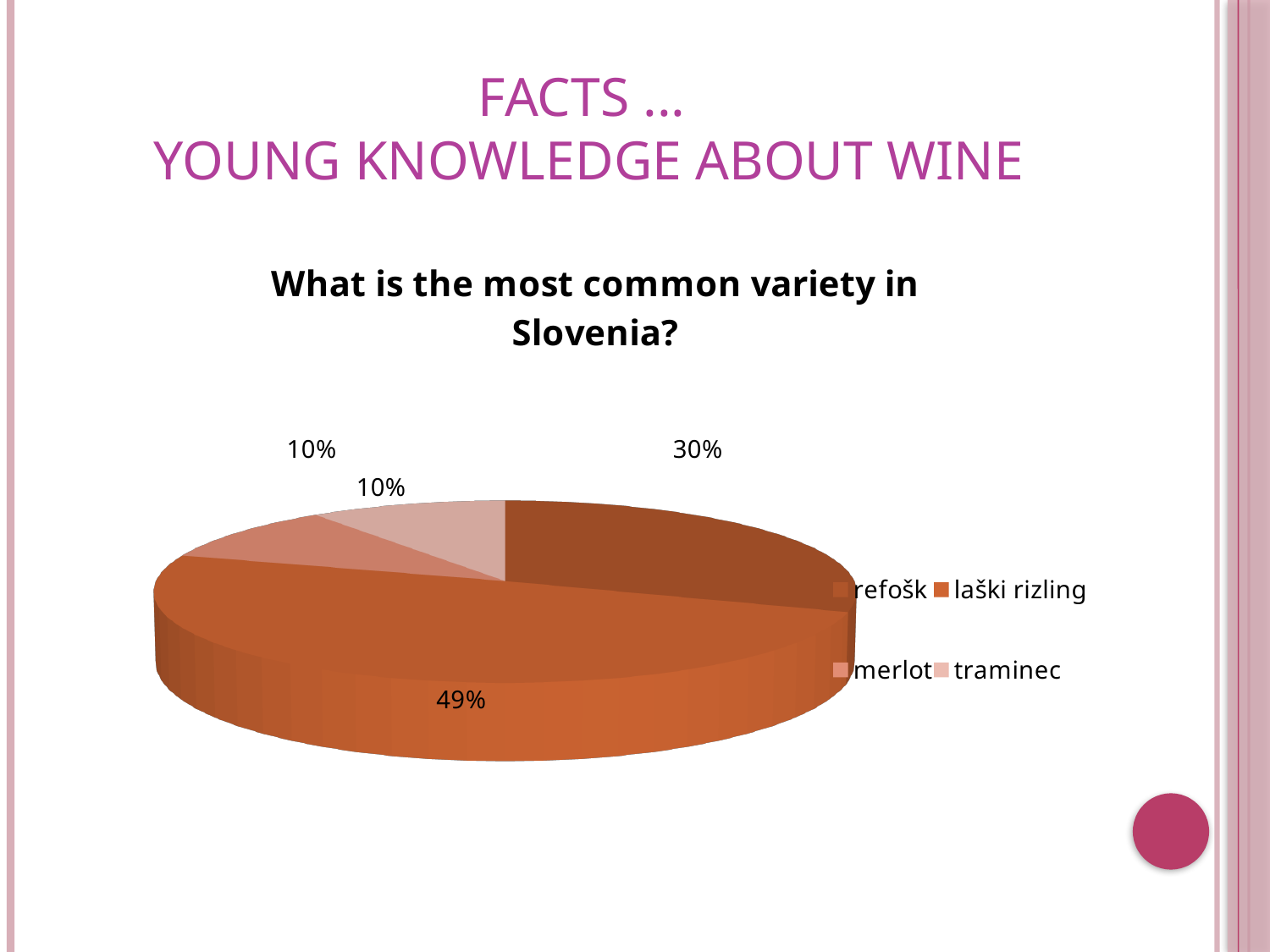
How many entries does the legend list? 4 Which variety has the largest slice of the pie? laški rizling What percentage of the pie does traminec represent? 10% Which is larger, the slice for refošk or the slice for merlot? refošk What percentage of the pie does laški rizling represent? 49% What is the title of the chart? What is the most common variety in Slovenia? How many slices does the pie chart have? 4 What percentage of the pie does refošk represent? 30% What percentage of the pie does merlot represent? 10% Which two varieties share the smallest slice of the pie? merlot and traminec What kind of chart is shown on the slide? pie chart What is the difference in percentage points between laški rizling and refošk? 19